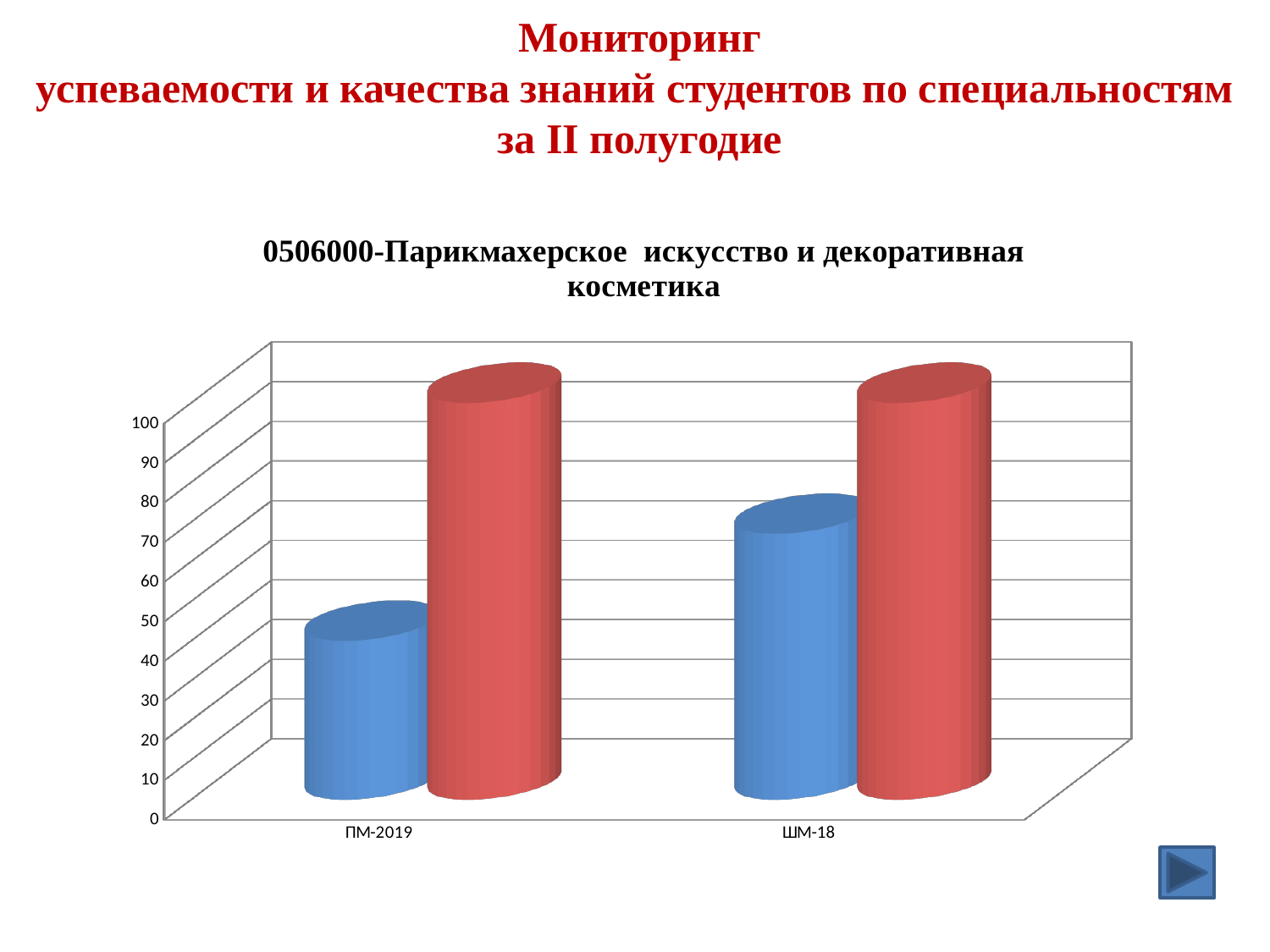
What two colours are used for the bars in the chart? blue and red Is the value of the blue bar for ПМ-2019 greater or less than 60? less What is the title of the chart? 0506000-Парикмахерское искусство и декоративная косметика Which category has the lowest blue bar? ПМ-2019 How many categories are shown on the x axis of the chart? 2 Is the value of the red bar for ШМ-18 greater or less than 90? greater What kind of chart is shown on the slide? bar chart Which category has the larger blue bar, ПМ-2019 or ШМ-18? ШМ-18 Is the value of the red bar for ПМ-2019 greater or less than 90? greater For ПМ-2019, which bar is larger, the blue one or the red one? the red one Does the blue series rise or fall from ПМ-2019 to ШМ-18? rise